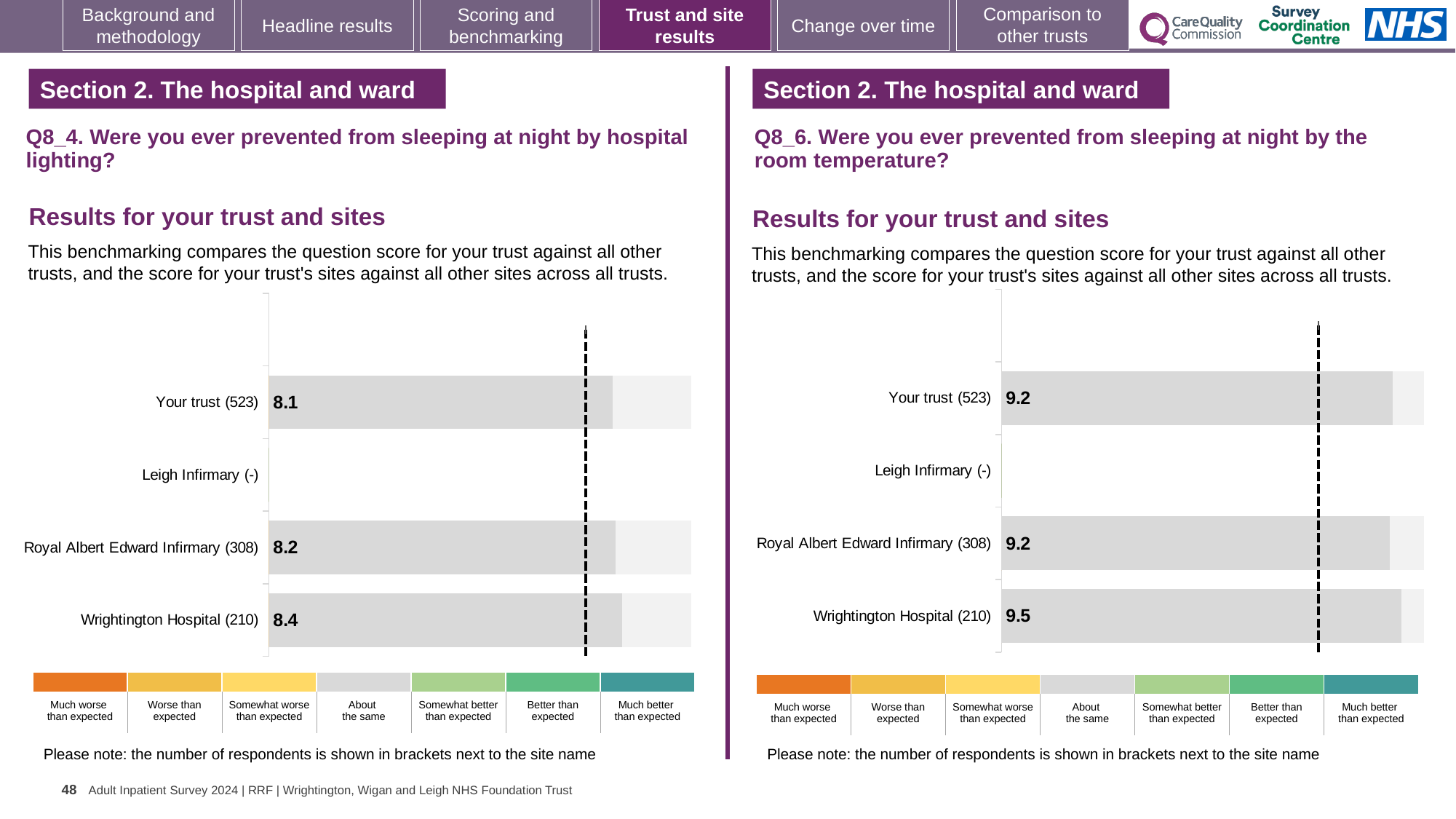
In the Q8_4 chart (hospital lighting), what is the difference between the scores for Wrightington Hospital and Your trust? 0.3 In the Q8_6 chart (room temperature), which site has the highest score? Wrightington Hospital In the Q8_4 chart (hospital lighting), what is the score for Royal Albert Edward Infirmary? 8.2 In the Q8_4 chart (hospital lighting), which has the larger score, Royal Albert Edward Infirmary or Your trust? Royal Albert Edward Infirmary In the Q8_6 chart (room temperature), what is the score for Your trust? 9.2 In the Q8_4 chart (hospital lighting), how many respondents are shown in brackets for Your trust? 523 In the Q8_6 chart (room temperature), what is the score for Wrightington Hospital? 9.5 What kind of chart is used in the Q8_6 chart (room temperature)? Bar chart In the Q8_6 chart (room temperature), what is the difference between the scores for Wrightington Hospital and Royal Albert Edward Infirmary? 0.3 In the Q8_4 chart (hospital lighting), which site has the highest score? Wrightington Hospital In the Q8_4 chart (hospital lighting), what is the score for Wrightington Hospital? 8.4 In the Q8_4 chart (hospital lighting), what is the score for Your trust? 8.1